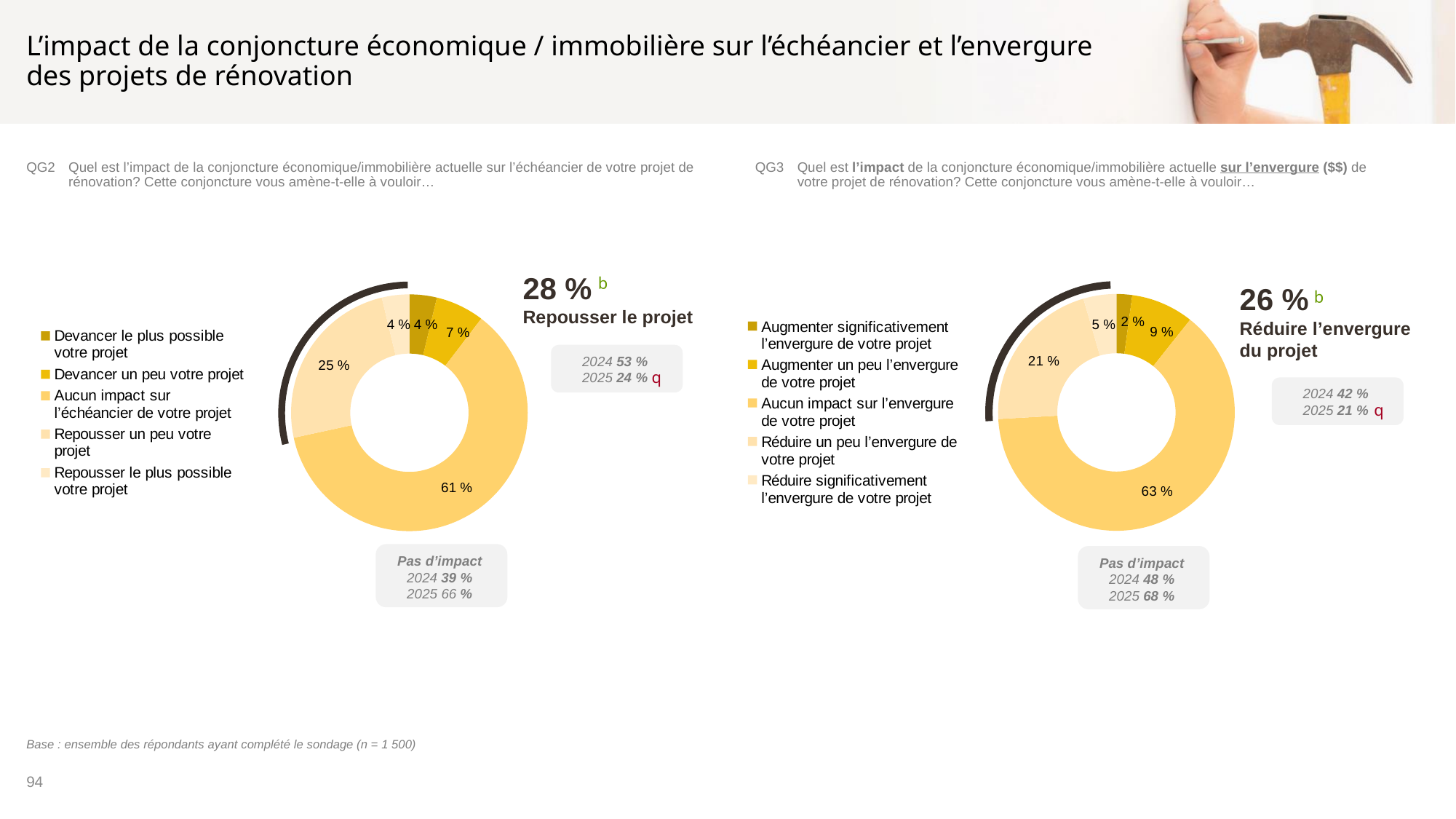
In the left donut chart (QG2), what percentage chose 'Devancer un peu votre projet'? 7 % How many categories does the legend of the left donut chart (QG2) list? 5 In the right donut chart (QG3), which category has the smallest share? Augmenter significativement l'envergure de votre projet What combined percentage is highlighted next to the right donut chart (QG3) for 'Réduire l'envergure du projet'? 26 % In the left donut chart (QG2), what is the difference between the 'Aucun impact' share and the 'Repousser un peu' share? 36 % In the right donut chart (QG3), what percentage chose 'Augmenter significativement l'envergure de votre projet'? 2 % In the left donut chart (QG2), what percentage chose 'Repousser un peu votre projet'? 25 % What type of chart is used for QG3 on the right side of the slide? Donut (pie) chart In the right donut chart (QG3), what percentage chose 'Réduire un peu l'envergure de votre projet'? 21 % In the right donut chart (QG3), which category has the largest share? Aucun impact sur l'envergure de votre projet In the left donut chart (QG2), what percentage of respondents said the economic situation has no impact on the schedule of their project (Aucun impact sur l'échéancier)? 61 % In the right donut chart (QG3), which is larger: 'Augmenter un peu l'envergure' or 'Réduire significativement l'envergure'? Augmenter un peu l'envergure de votre projet